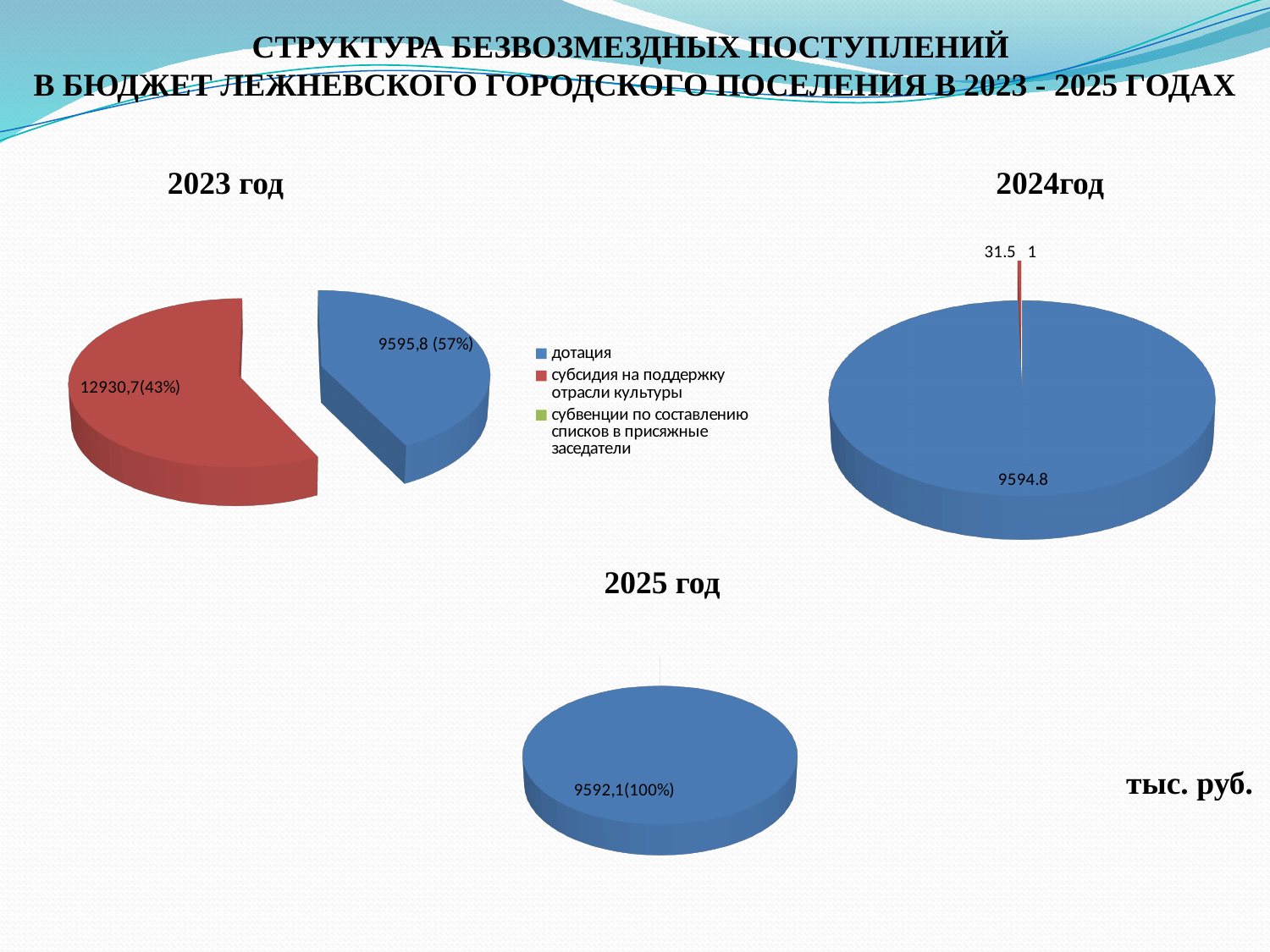
In the 2023 год chart, what value is shown for субсидия на поддержку отрасли культуры? 12930,7(43%) In the 2024год chart, what value is labelled on the small red slice? 31.5 In the 2024год chart, which category has the largest slice? дотация In the 2025 год chart, what value is shown for дотация? 9592,1(100%) What type of chart is used on this slide for each year? pie chart In the 2024год chart, what value is shown for дотация? 9594.8 How many categories does the legend list? 3 How many pie charts are on the slide? 3 In the 2023 год chart, what value is shown for дотация? 9595,8 (57%) What unit of measurement is indicated on the slide for the values? тыс. руб. How many slices does the 2023 год pie chart have? 2 In the 2025 год chart, what share of the pie does дотация take? 100%